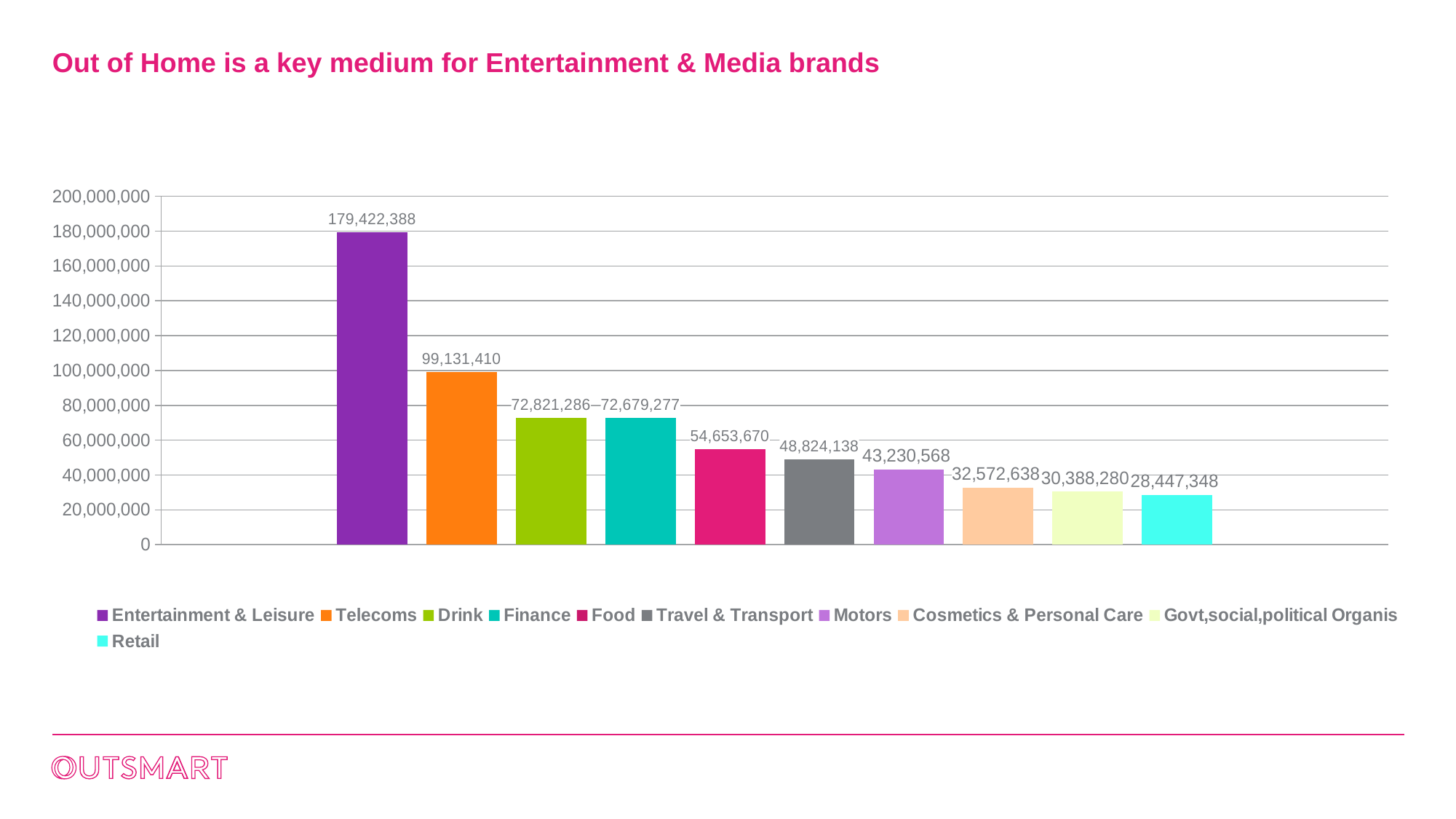
What is the difference between the values for Entertainment & Leisure and Telecoms? 80,290,978 What is the value for Telecoms? 99,131,410 What is the value for Retail? 28,447,348 Which category has the highest value? Entertainment & Leisure What is the value for Entertainment & Leisure? 179,422,388 What is the value for Travel & Transport? 48,824,138 Is the value for Motors greater or less than 40,000,000? greater Which category has the lowest value? Retail Which has a larger value, Telecoms or Food? Telecoms What kind of chart is shown on the slide? Bar chart What is the difference between the values for Food and Travel & Transport? 5,829,532 How many categories are shown in the chart? 10